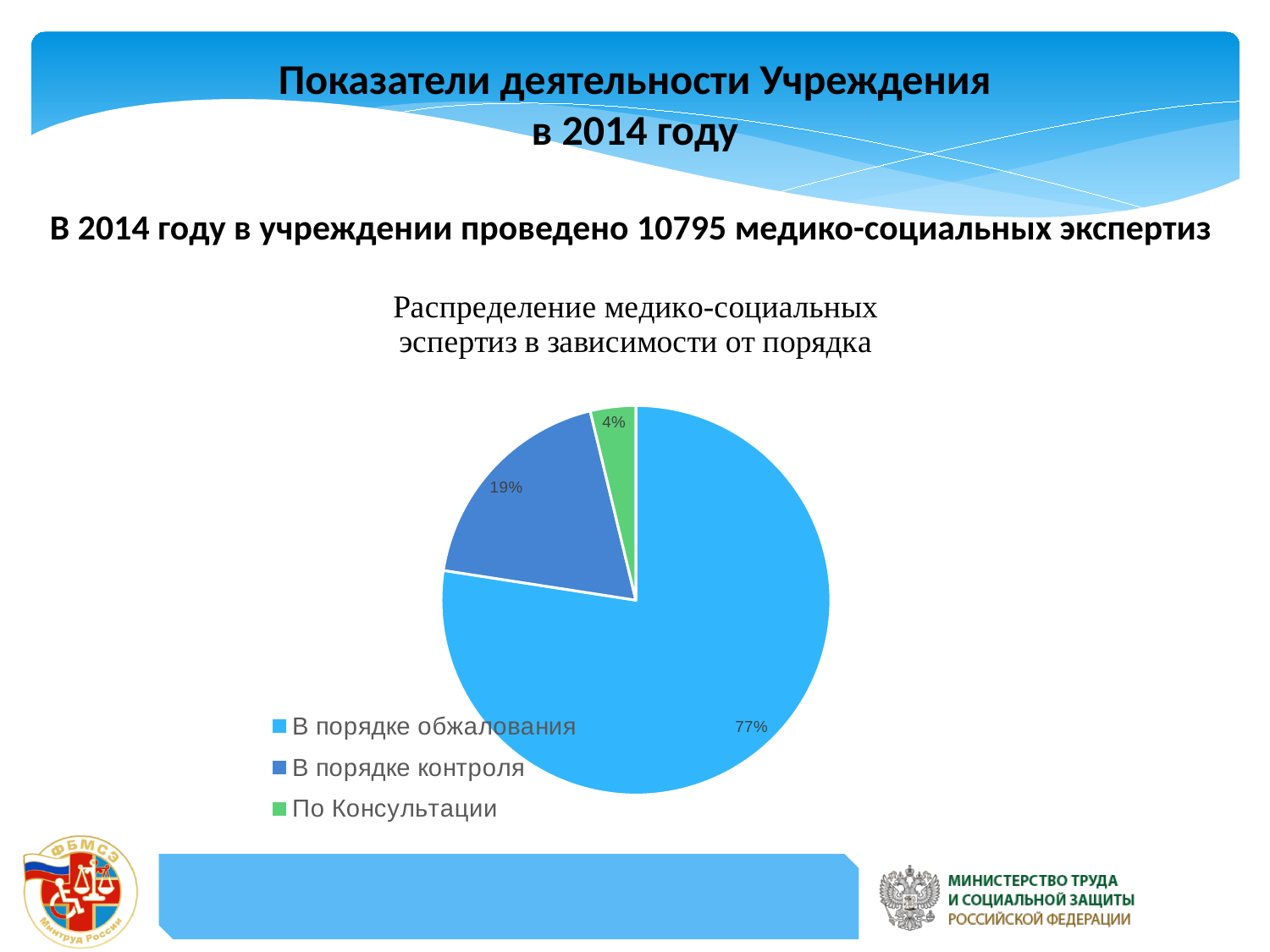
What share of the pie does 'По Консультации' have? 4% How many slices does the pie chart have? 3 Which is larger: the share for 'В порядке контроля' or the share for 'По Консультации'? В порядке контроля What is the difference in percentage points between 'В порядке обжалования' and 'В порядке контроля'? 58 What kind of chart is shown on the slide? pie chart Which category has the smallest share of the pie? По Консультации What is the title of the pie chart? Распределение медико-социальных эспертиз в зависимости от порядка How many entries does the legend list? 3 What share of the pie does 'В порядке обжалования' have? 77% Which category has the largest share of the pie? В порядке обжалования What share of the pie does 'В порядке контроля' have? 19% What colour is the slice for 'По Консультации'? green